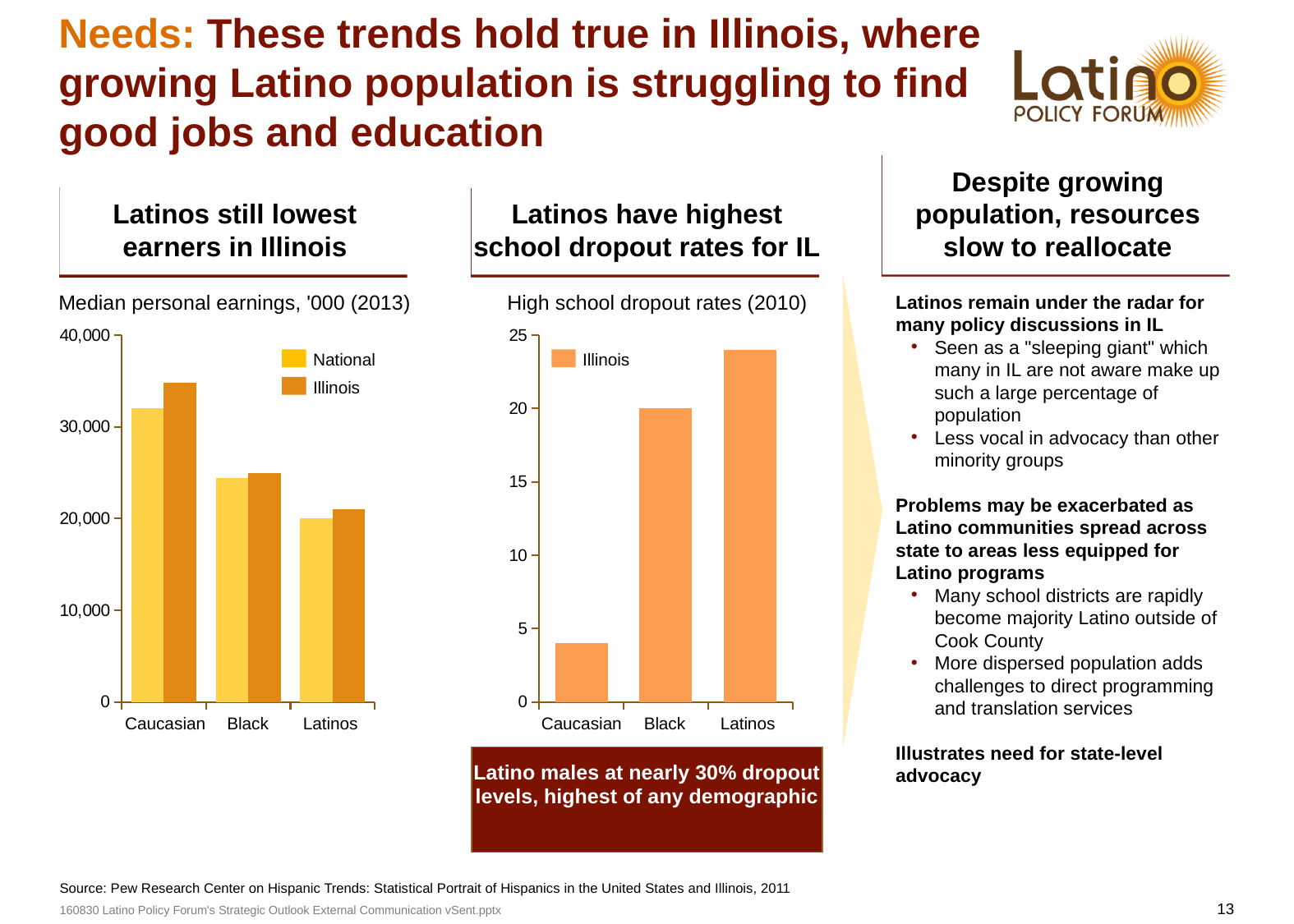
In the 'High school dropout rates (2010)' chart, do the values rise or fall from Caucasian to Latinos along the x axis? rise In the 'Median personal earnings, '000 (2013)' chart, which category has the highest earnings? Caucasian How many categories are shown on the x axis of the 'High school dropout rates (2010)' chart? 3 In the 'Median personal earnings, '000 (2013)' chart, which is larger for Caucasian: the National value or the Illinois value? Illinois In the 'High school dropout rates (2010)' chart, is the value for Caucasian greater or less than 5? less In the 'Median personal earnings, '000 (2013)' chart, which category has the lowest earnings? Latinos In the 'High school dropout rates (2010)' chart, which category has the lowest dropout rate? Caucasian In the 'High school dropout rates (2010)' chart, which category has the highest dropout rate? Latinos How many series does the legend of the 'Median personal earnings, '000 (2013)' chart list? 2 In the 'Median personal earnings, '000 (2013)' chart, is the National value for Black greater or less than 30,000? less What kind of chart is the 'Median personal earnings, '000 (2013)' chart? bar chart In the 'Median personal earnings, '000 (2013)' chart, is the Illinois value for Caucasian greater or less than 30,000? greater